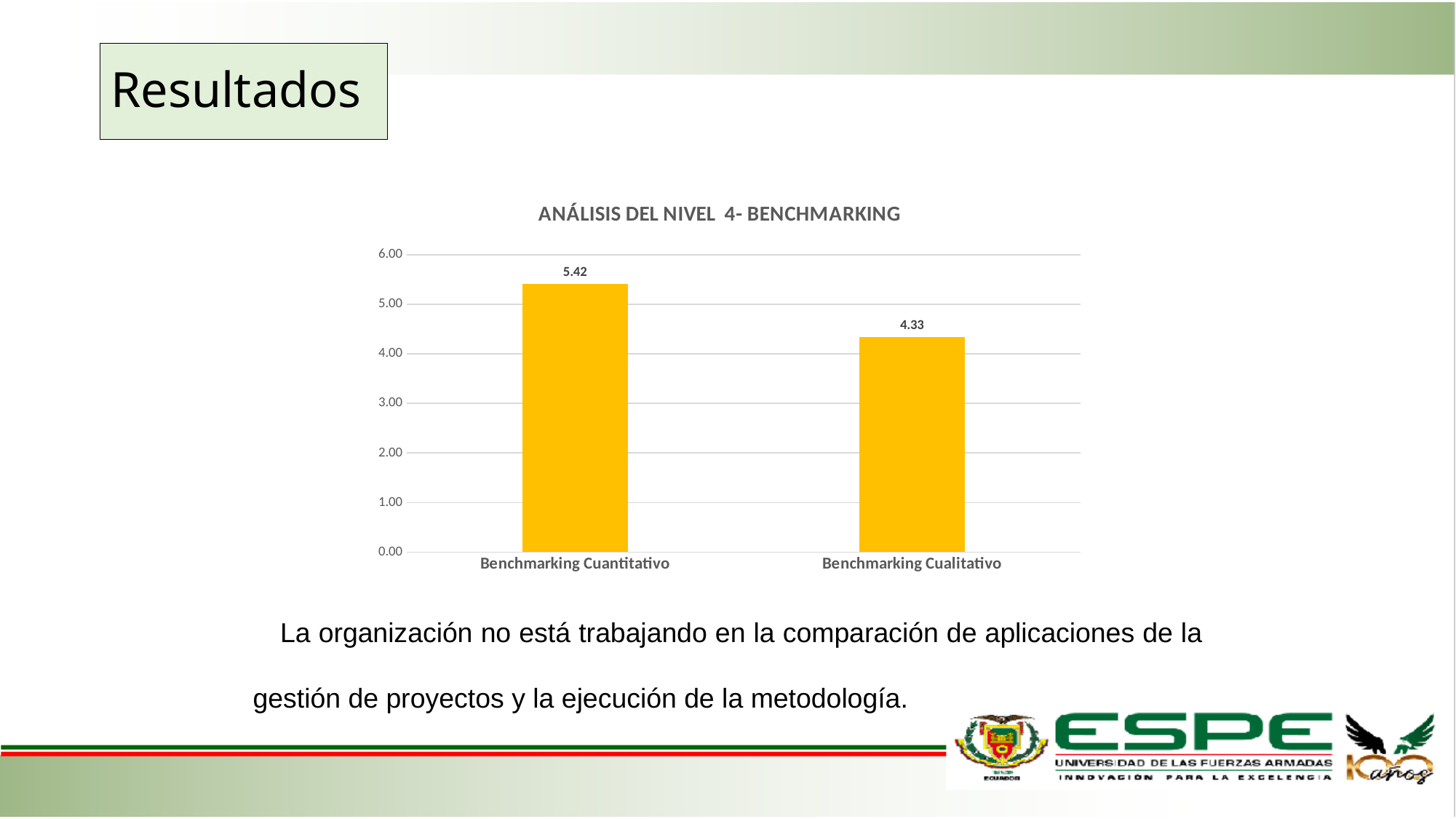
What is the difference between the values for Benchmarking Cuantitativo and Benchmarking Cualitativo? 1.09 What is the value for Benchmarking Cualitativo? 4.33 Is the value for Benchmarking Cuantitativo greater or less than 5.00? greater Which category has the lowest value? Benchmarking Cualitativo What is the title of the chart? ANÁLISIS DEL NIVEL 4- BENCHMARKING How many categories are shown on the chart? 2 What is the maximum value shown on the vertical axis? 6.00 What is the value for Benchmarking Cuantitativo? 5.42 Which category has the highest value? Benchmarking Cuantitativo Is the value for Benchmarking Cualitativo greater or less than 5.00? less Which is larger, the value for Benchmarking Cuantitativo or Benchmarking Cualitativo? Benchmarking Cuantitativo What kind of chart is shown on the slide? Bar chart